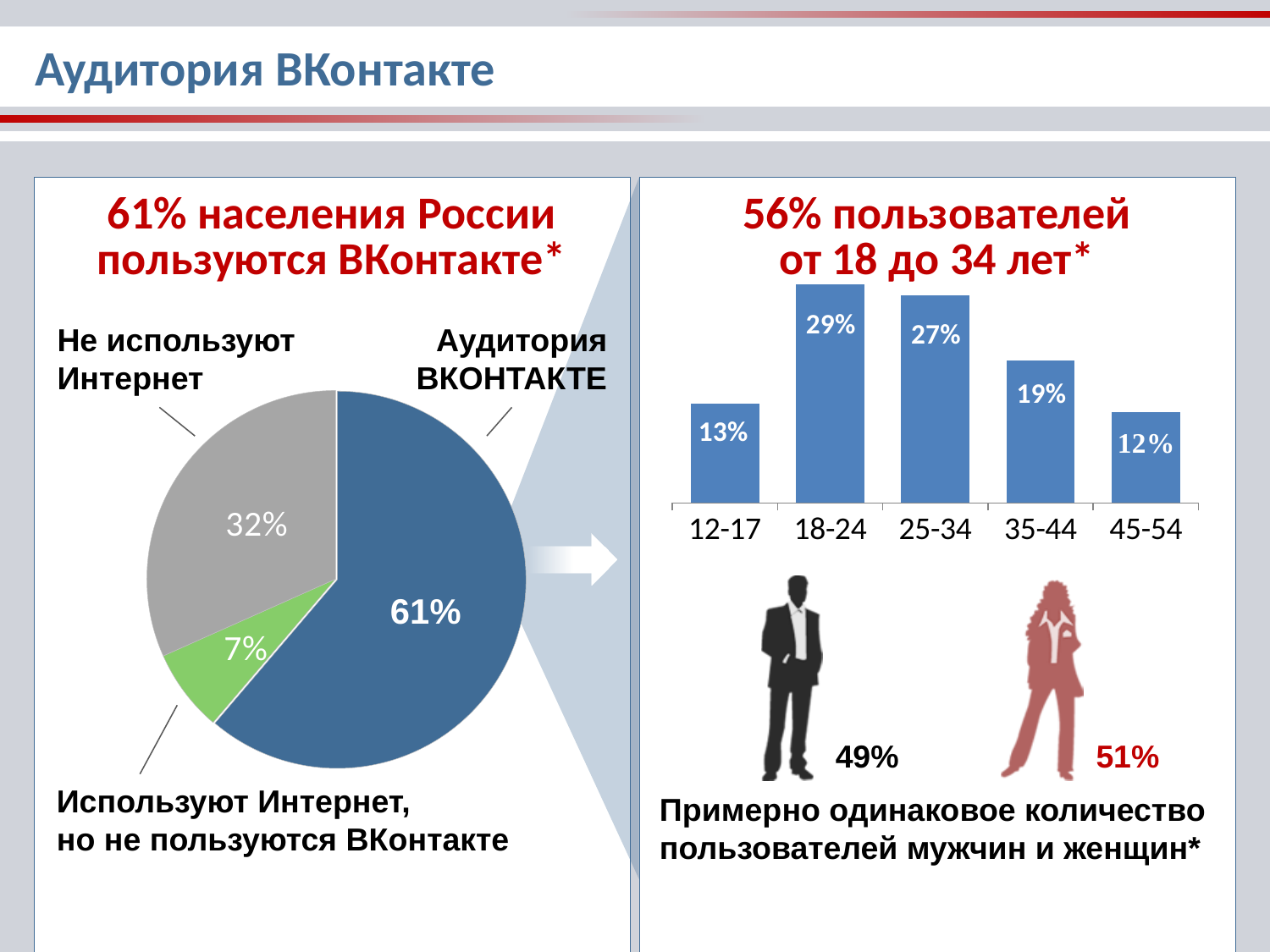
In the pie chart on the left, what share is labelled "Используют Интернет, но не пользуются ВКонтакте"? 7% In the pie chart on the left, what share is labelled "Не используют Интернет"? 32% In the bar chart on the right, which age group has the highest value? 18-24 In the bar chart on the right, what is the value for the 18-24 age group? 29% In the pie chart on the left, how many slices are there? 3 What type of chart is shown on the left side of the slide? Pie chart In the bar chart on the right, what is the difference between the values for 25-34 and 35-44? 8% In the pie chart on the left, which slice is the smallest? Используют Интернет, но не пользуются ВКонтакте In the pie chart on the left, what share is labelled "Аудитория ВКОНТАКТЕ"? 61% In the bar chart on the right, how many age groups are shown? 5 In the bar chart on the right, what is the value for the 45-54 age group? 12% In the bar chart on the right, which is larger: the value for 12-17 or the value for 35-44? 35-44